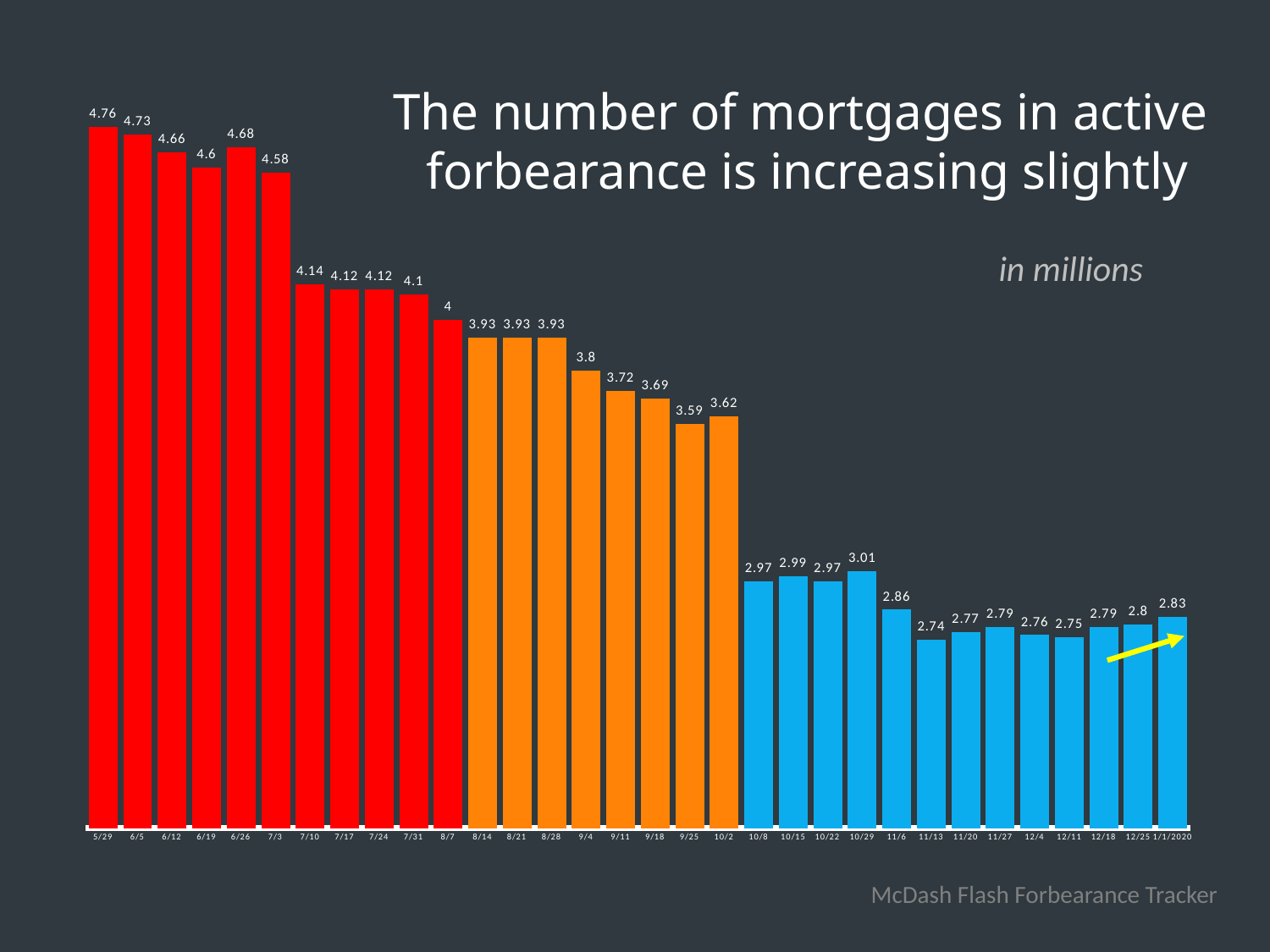
What kind of chart is shown on the slide? Bar chart What is the difference between the values for 1/1/2020 and 11/13? 0.09 In what units are the values on the chart expressed? In millions Which date has the lowest value? 11/13 What is the difference between the values for 5/29 and 11/13? 2.02 Do the values generally rise or fall from 5/29 to 1/1/2020? Fall What is the value for 1/1/2020? 2.83 Which is larger, the value for 6/26 or the value for 6/19? 6/26 What is the value for 10/29? 3.01 Which date has the highest value? 5/29 What is the value for 5/29? 4.76 How many bars are plotted in the chart? 32